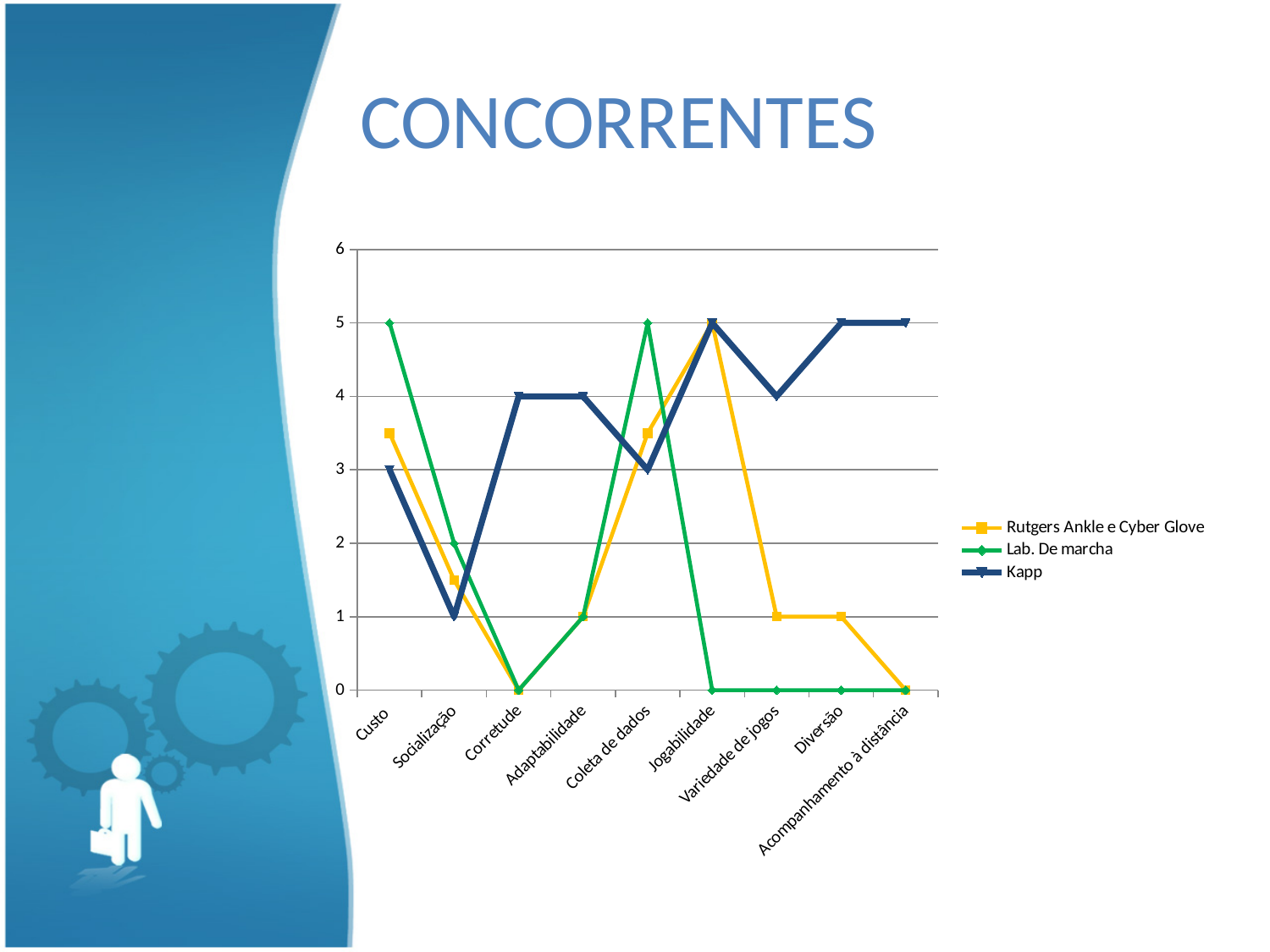
What is the value for Lab. De marcha at Custo? 5 What is the value for Kapp at Corretude? 4 Which series has the highest value at Diversão? Kapp What kind of chart is shown on the slide? line chart Is the value for Rutgers Ankle e Cyber Glove at Custo greater or less than 3? greater What is the difference between the Kapp value and the Lab. De marcha value at Variedade de jogos? 4 Which series has the lowest value at Custo? Kapp How many categories are shown on the x axis? 9 What is the value for Rutgers Ankle e Cyber Glove at Jogabilidade? 5 What is the value for Kapp at Acompanhamento à distância? 5 How many series does the legend list? 3 Which is larger at Adaptabilidade: the value for Kapp or the value for Lab. De marcha? Kapp